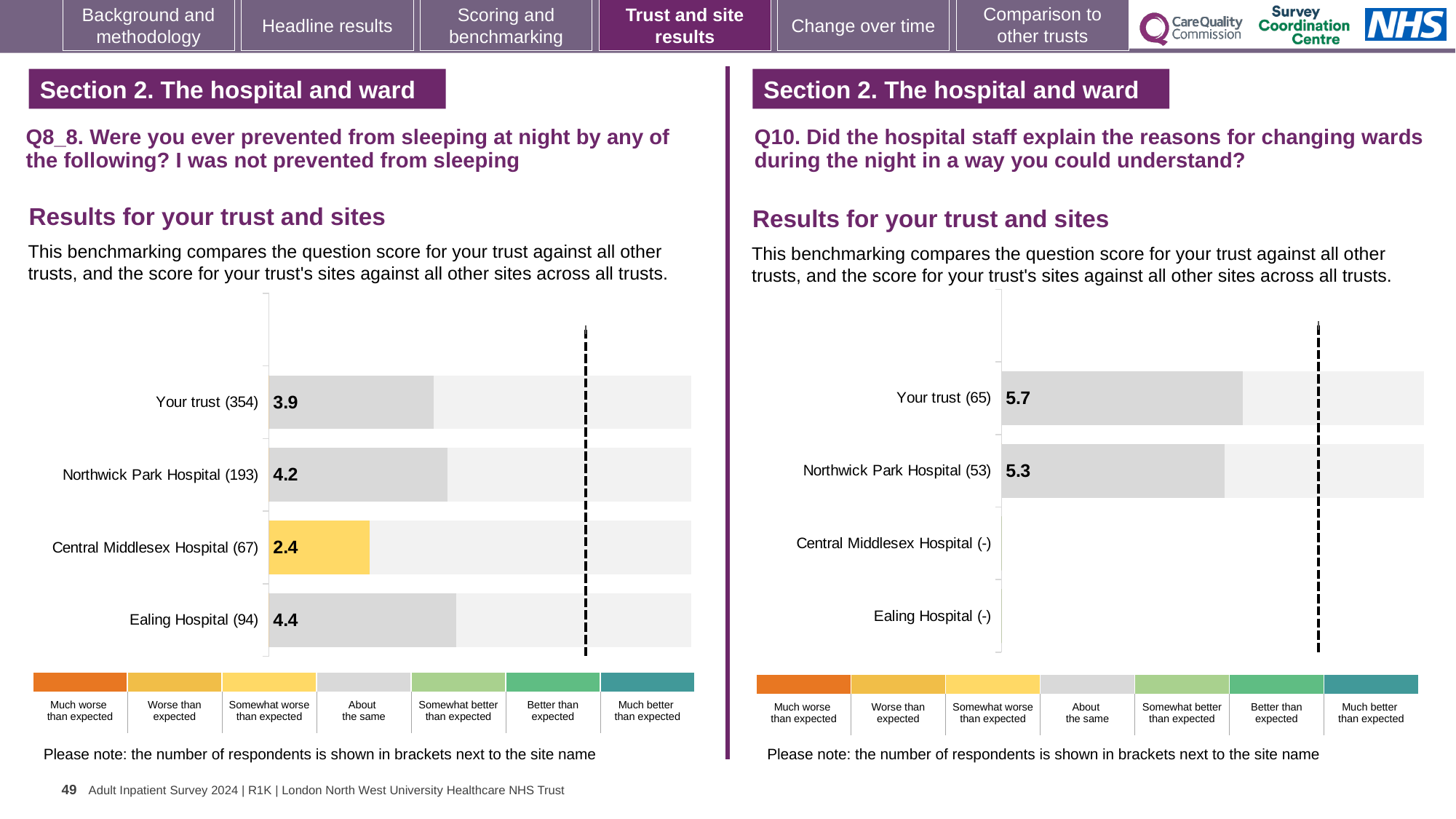
In the Q8_8 chart on the left, which site has the lowest score? Central Middlesex Hospital (67) In the Q8_8 chart on the left, which has the higher score, Northwick Park Hospital (193) or Your trust (354)? Northwick Park Hospital (193) In the Q8_8 chart on the left, which site has the highest score? Ealing Hospital (94) In the Q8_8 chart on the left, what is the score for Your trust (354)? 3.9 In the Q10 chart on the right, what is the difference between the scores for Your trust (65) and Northwick Park Hospital (53)? 0.4 What kind of chart is the Q10 chart on the right? Bar chart In the Q10 chart on the right, what is the score for Northwick Park Hospital (53)? 5.3 In the Q8_8 chart on the left, what is the difference between the scores for Ealing Hospital (94) and Central Middlesex Hospital (67)? 2.0 In the Q8_8 chart on the left, what is the score for Central Middlesex Hospital (67)? 2.4 In the Q8_8 chart on the left, what colour is the bar for Central Middlesex Hospital (67)? Yellow In the Q10 chart on the right, what is the score for Your trust (65)? 5.7 In the Q8_8 chart on the left, how many bars are plotted? 4